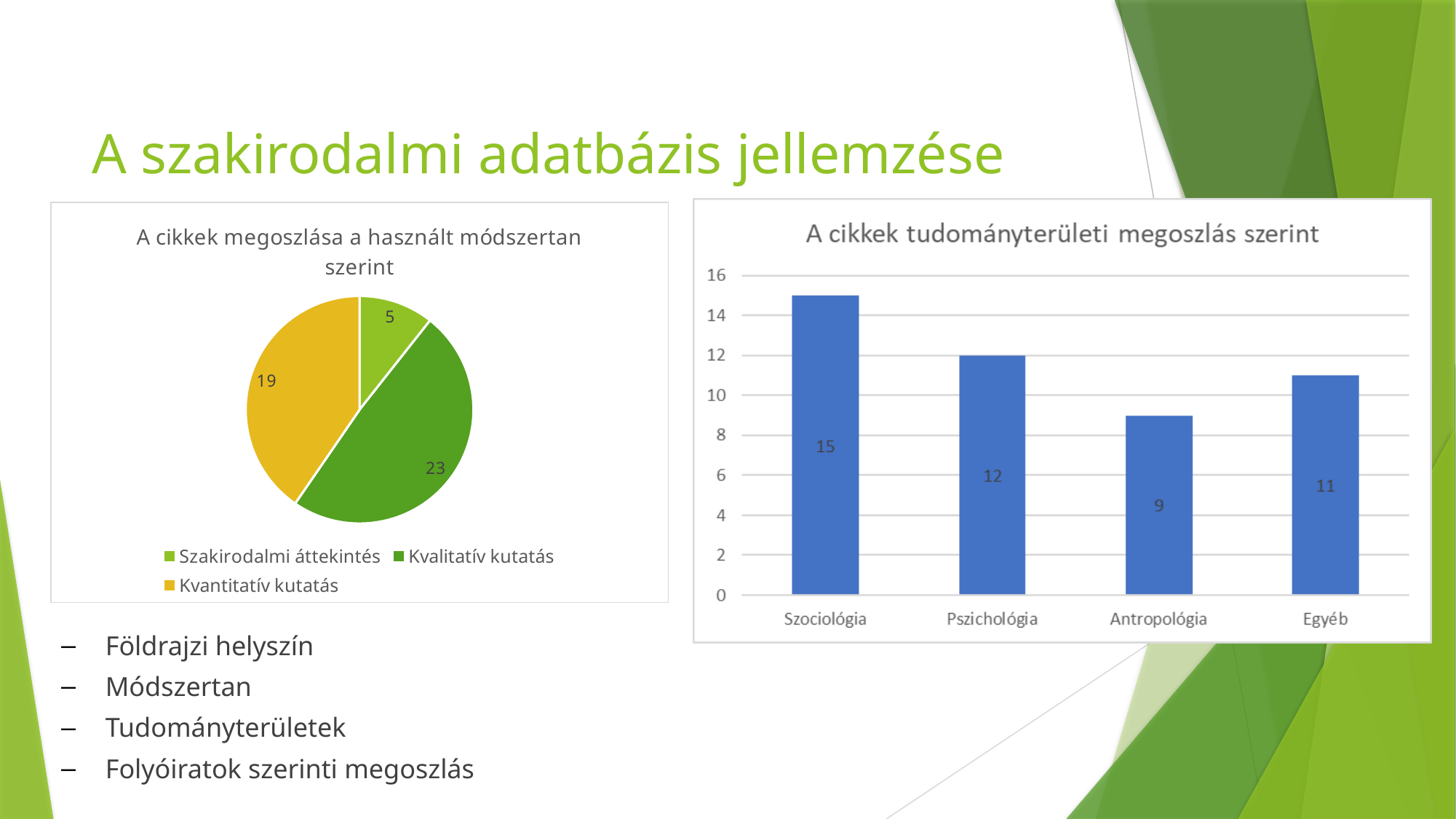
In the bar chart 'A cikkek tudományterületi megoszlás szerint', which category has the highest value? Szociológia In the bar chart 'A cikkek tudományterületi megoszlás szerint', which is larger, Pszichológia or Egyéb? Pszichológia In the pie chart 'A cikkek megoszlása a használt módszertan szerint', how many categories does the legend list? 3 What type of chart is 'A cikkek megoszlása a használt módszertan szerint'? pie chart In the pie chart 'A cikkek megoszlása a használt módszertan szerint', which category has the largest slice? Kvalitatív kutatás In the pie chart 'A cikkek megoszlása a használt módszertan szerint', what is the value for Szakirodalmi áttekintés? 5 In the bar chart 'A cikkek tudományterületi megoszlás szerint', what is the difference between Szociológia and Egyéb? 4 In the pie chart 'A cikkek megoszlása a használt módszertan szerint', what is the difference between Kvantitatív kutatás and Szakirodalmi áttekintés? 14 In the bar chart 'A cikkek tudományterületi megoszlás szerint', which category has the lowest value? Antropológia In the bar chart 'A cikkek tudományterületi megoszlás szerint', what is the value for Pszichológia? 12 In the pie chart 'A cikkek megoszlása a használt módszertan szerint', what is the value for Kvalitatív kutatás? 23 In the bar chart 'A cikkek tudományterületi megoszlás szerint', how many categories are shown on the x axis? 4